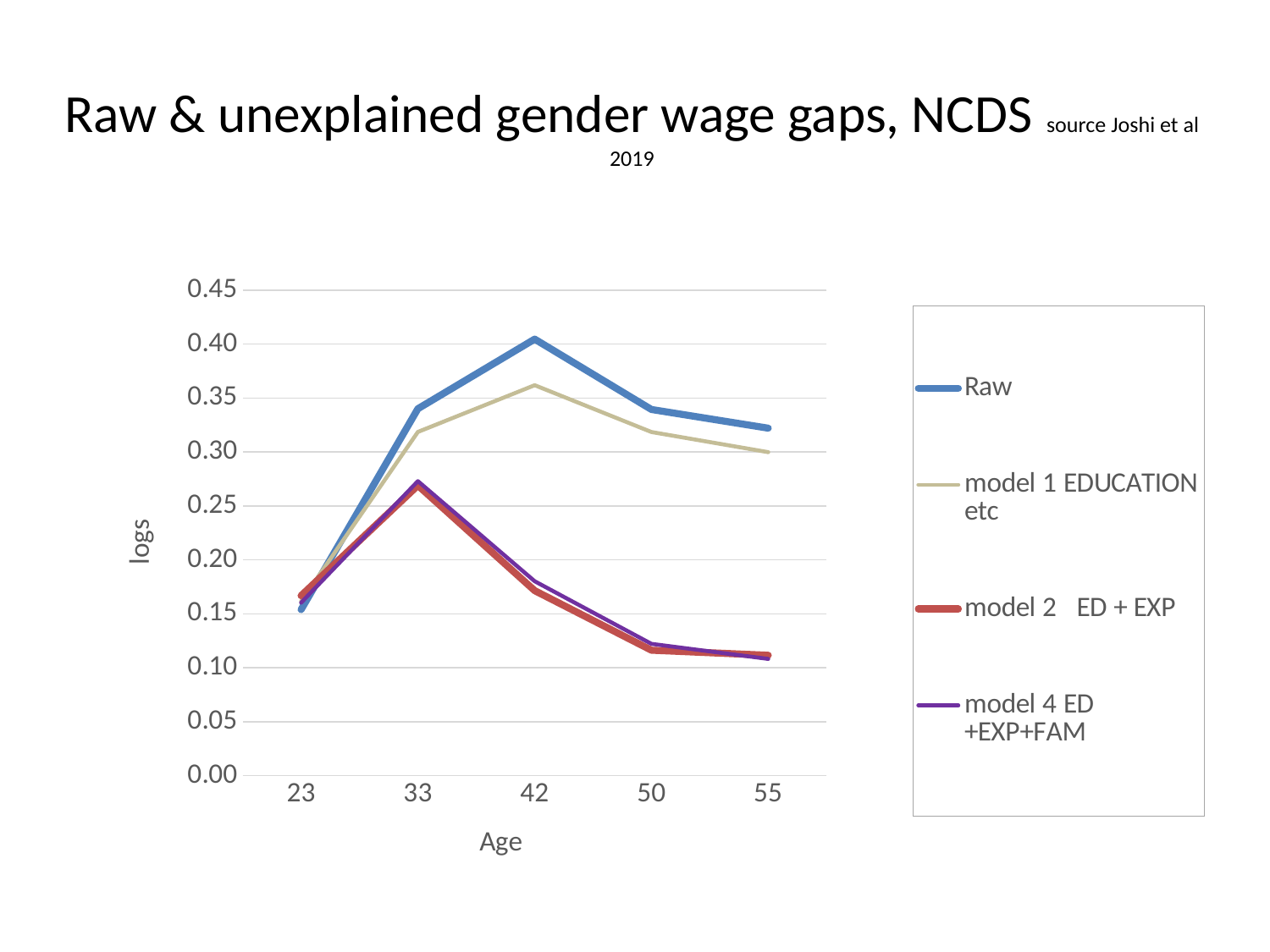
Is the value of the Raw series at age 42 greater or less than 0.35? greater Does the Raw series rise or fall between age 42 and age 55? fall At which age does the Raw series reach its highest value? 42 At which age is the Raw series at its lowest value? 23 At age 42, which series has the larger value: Raw or model 1 EDUCATION etc? Raw Is the value of the model 1 EDUCATION etc series at age 33 greater or less than 0.30? greater Is the value of the model 2 ED + EXP series at age 50 greater or less than 0.15? less How many age points are plotted along the x axis? 5 How many series does the legend list? 4 What is the label on the x axis? Age What is the label on the y axis? logs What kind of chart is shown on the slide? line chart